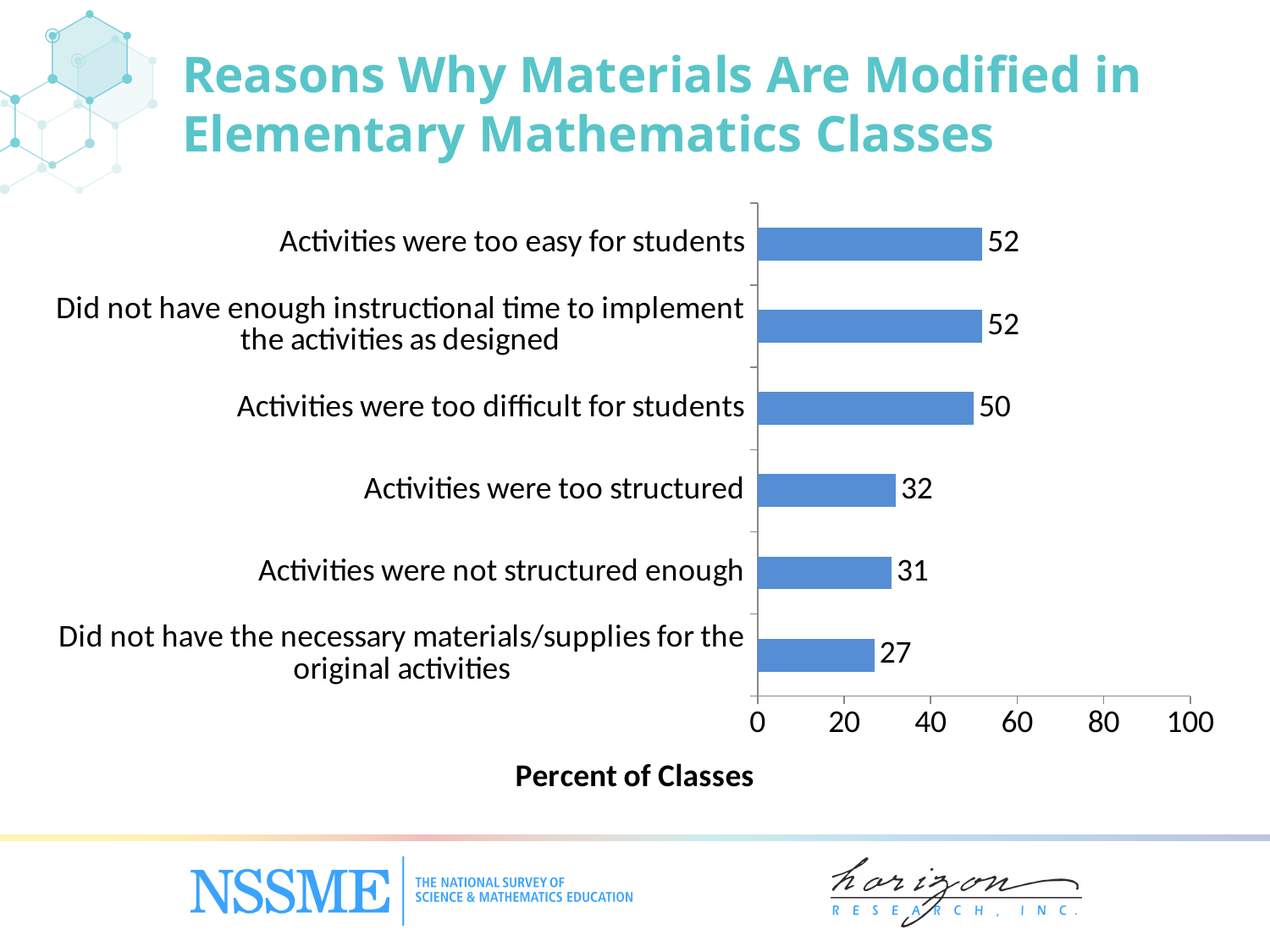
Which reason has the lowest percent of classes? Did not have the necessary materials/supplies for the original activities What percent of classes reported that activities were too easy for students? 52 Which is larger: the value for 'Activities were too structured' or 'Activities were not structured enough'? Activities were too structured What percent of classes reported that activities were too structured? 32 What is the value for 'Did not have the necessary materials/supplies for the original activities'? 27 How many reasons are shown in the chart? 6 What is the title of the chart? Reasons Why Materials Are Modified in Elementary Mathematics Classes What kind of chart is shown on the slide? Bar chart Is the value for 'Activities were too difficult for students' greater or less than 40? greater What is the label of the horizontal axis? Percent of Classes What is the value for 'Activities were too difficult for students'? 50 What is the difference between the values for 'Activities were too easy for students' and 'Activities were not structured enough'? 21